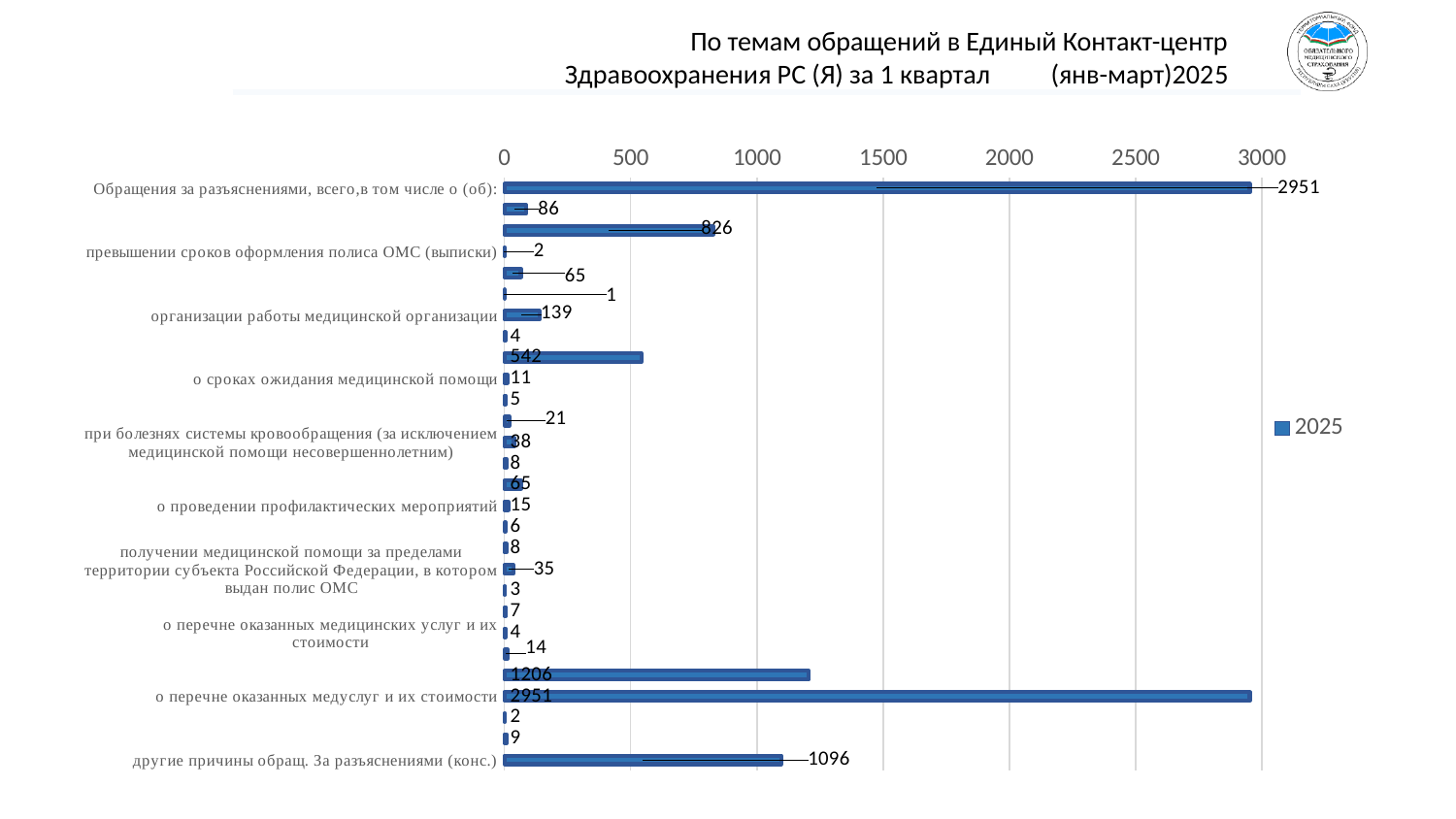
What is the difference between the values for 'организации работы медицинской организации' and 'о проведении профилактических мероприятий'? 124 What kind of chart is shown on the slide? bar chart What is the value for 'превышении сроков оформления полиса ОМС (выписки)'? 2 What is the value for 'Обращения за разъяснениями, всего,в том числе о (об):'? 2951 What is the value for 'другие причины обращ. За разъяснениями (конс.)'? 1096 Which is larger: the value for 'другие причины обращ. За разъяснениями (конс.)' or the value for 'организации работы медицинской организации'? другие причины обращ. За разъяснениями (конс.) What year is shown in the chart legend? 2025 What is the value for 'о проведении профилактических мероприятий'? 15 What is the value for 'о сроках ожидания медицинской помощи'? 11 What is the value for 'организации работы медицинской организации'? 139 How many series does the legend list? 1 Is the value for 'другие причины обращ. За разъяснениями (конс.)' greater or less than 1000? greater